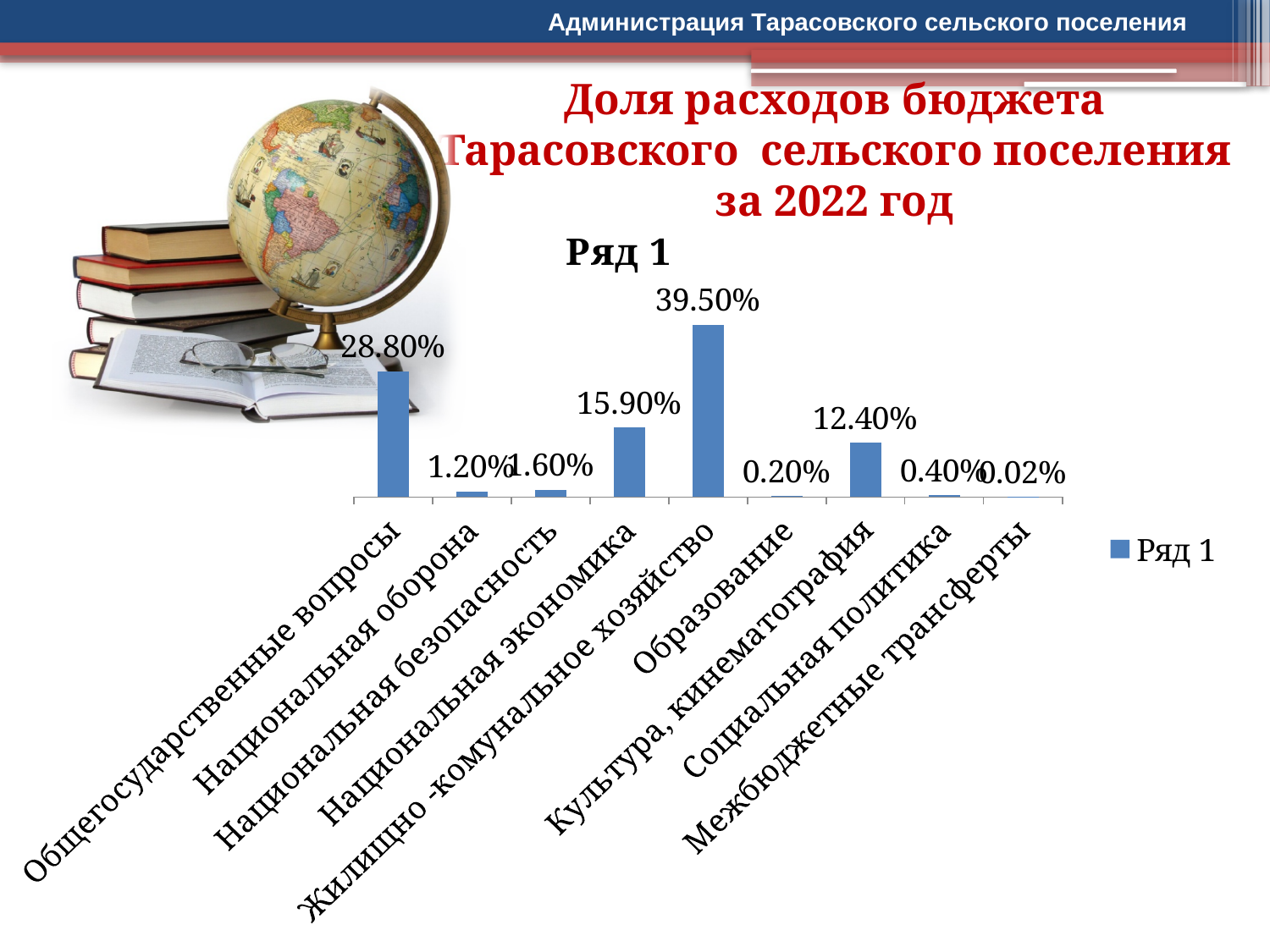
What is the value for Жилищно-коммунальное хозяйство? 39.50% What kind of chart is shown on the slide? Bar chart What is the value for Культура, кинематография? 12.40% What is the value for Общегосударственные вопросы? 28.80% What is the difference between the values for Жилищно-коммунальное хозяйство and Общегосударственные вопросы? 10.70% How many categories are shown on the x axis? 9 How many series does the legend list? 1 What is the value for Межбюджетные трансферты? 0.02% What is the name of the series shown in the legend? Ряд 1 Which is larger, the value for Национальная экономика or the value for Культура, кинематография? Национальная экономика Which category has the lowest value? Межбюджетные трансферты Which category has the highest value? Жилищно-коммунальное хозяйство